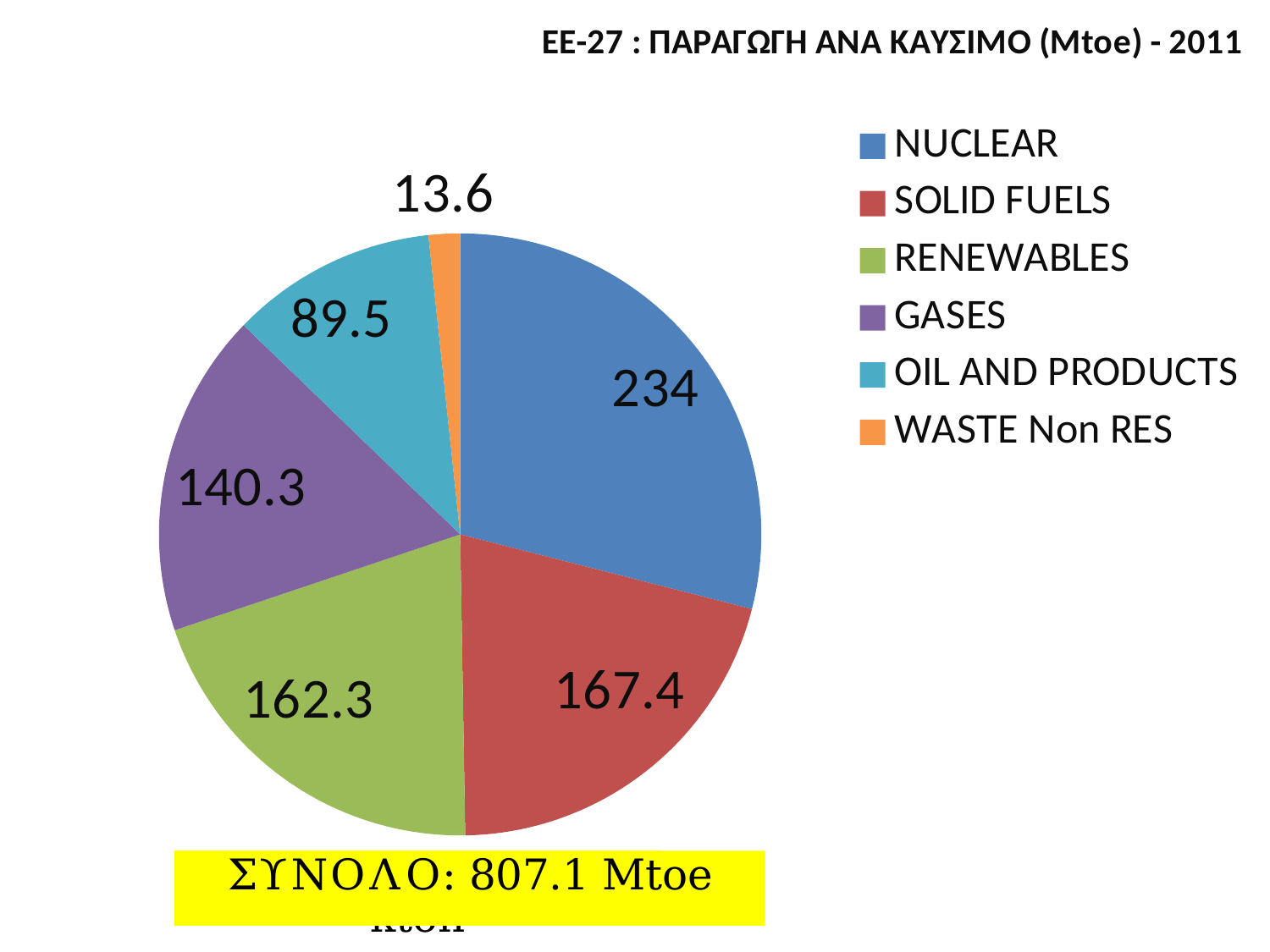
How many categories does the pie chart have? 6 What colour is the RENEWABLES slice in the pie chart? green What is the value for NUCLEAR in the pie chart? 234 What is the value for SOLID FUELS in the pie chart? 167.4 What type of chart is shown on the slide? pie chart What is the difference between the NUCLEAR and SOLID FUELS values? 66.6 Which category has the smallest slice in the pie chart? WASTE Non RES What is the value for OIL AND PRODUCTS in the pie chart? 89.5 What total is shown in the yellow box below the pie chart? 807.1 Mtoe Which category has the largest slice in the pie chart? NUCLEAR What is the value for GASES in the pie chart? 140.3 Which is larger, SOLID FUELS or RENEWABLES? SOLID FUELS